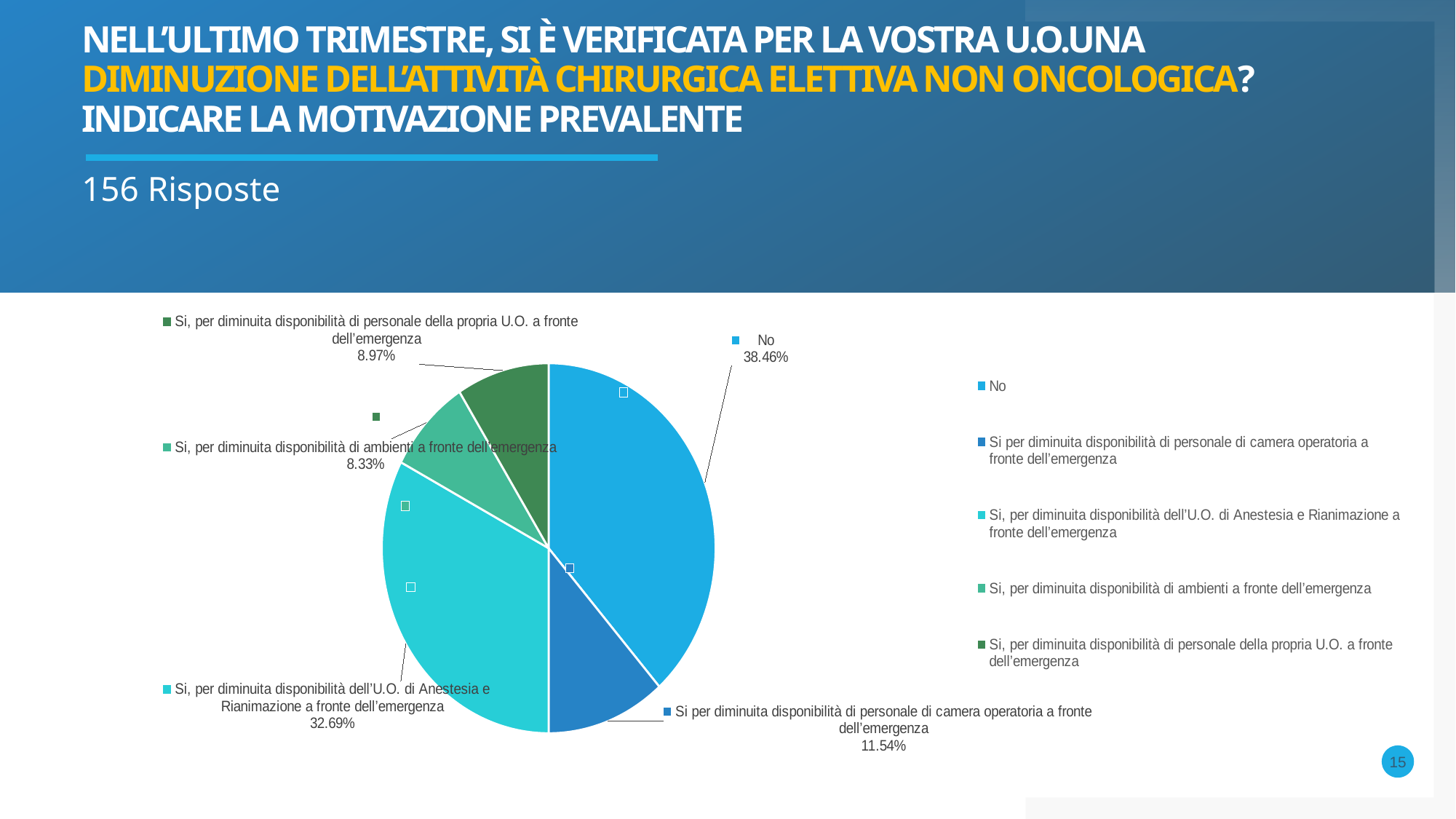
Which response has the smallest share of the pie? Si, per diminuita disponibilità di ambienti a fronte dell'emergenza What percentage of responses is "No"? 38.46% Which response has the largest share of the pie? No How many slices does the pie chart have? 5 What kind of chart is shown on the slide? Pie chart What is the difference in percentage points between "No" and "Si, per diminuita disponibilità dell'U.O. di Anestesia e Rianimazione a fronte dell'emergenza"? 5.77 How many responses does the slide say the chart is based on? 156 What percentage of responses is "Si per diminuita disponibilità di personale di camera operatoria a fronte dell'emergenza"? 11.54% What percentage of responses is "Si, per diminuita disponibilità dell'U.O. di Anestesia e Rianimazione a fronte dell'emergenza"? 32.69% Which is larger: the share for "Si per diminuita disponibilità di personale di camera operatoria a fronte dell'emergenza" or for "Si, per diminuita disponibilità di personale della propria U.O. a fronte dell'emergenza"? Si per diminuita disponibilità di personale di camera operatoria a fronte dell'emergenza What percentage of responses is "Si, per diminuita disponibilità di ambienti a fronte dell'emergenza"? 8.33% What percentage of responses is "Si, per diminuita disponibilità di personale della propria U.O. a fronte dell'emergenza"? 8.97%